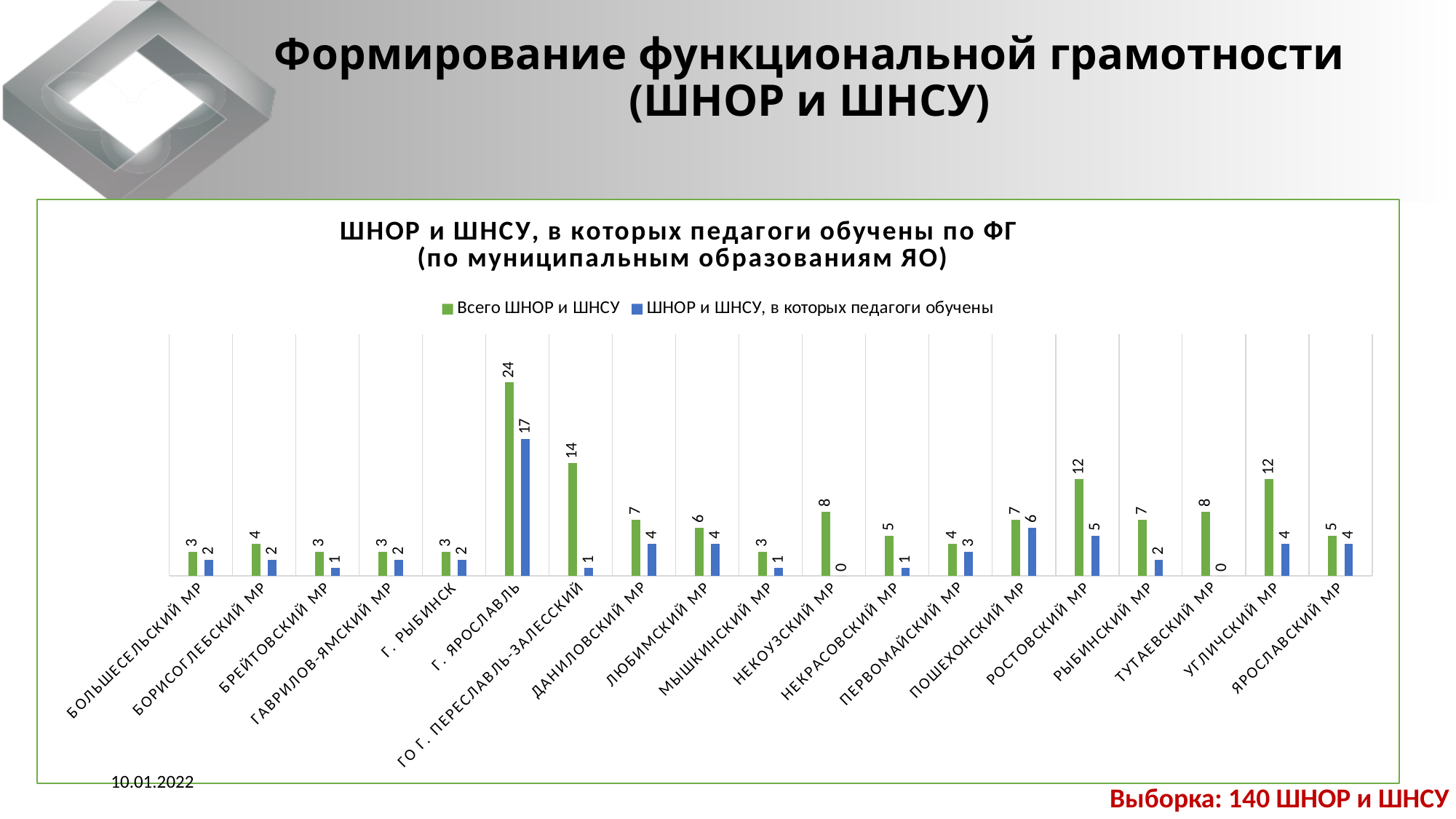
What is the difference between "Всего ШНОР и ШНСУ" for УГЛИЧСКИЙ МР and for ЯРОСЛАВСКИЙ МР? 7 How many series does the legend list? 2 What is the value of "ШНОР и ШНСУ, в которых педагоги обучены" for ГО Г. ПЕРЕСЛАВЛЬ-ЗАЛЕССКИЙ? 1 What is the value of "ШНОР и ШНСУ, в которых педагоги обучены" for РОСТОВСКИЙ МР? 5 What is the value of "Всего ШНОР и ШНСУ" for Г. ЯРОСЛАВЛЬ? 24 Which category has the highest value of "ШНОР и ШНСУ, в которых педагоги обучены"? Г. ЯРОСЛАВЛЬ Which is larger: "Всего ШНОР и ШНСУ" for ГО Г. ПЕРЕСЛАВЛЬ-ЗАЛЕССКИЙ or for РОСТОВСКИЙ МР? ГО Г. ПЕРЕСЛАВЛЬ-ЗАЛЕССКИЙ Which colour represents the series "Всего ШНОР и ШНСУ"? Green Which category has the highest value of "Всего ШНОР и ШНСУ"? Г. ЯРОСЛАВЛЬ How many municipal categories are shown on the x axis? 19 What kind of chart is shown on the slide? Bar chart What is the difference between "Всего ШНОР и ШНСУ" and "ШНОР и ШНСУ, в которых педагоги обучены" for Г. ЯРОСЛАВЛЬ? 7